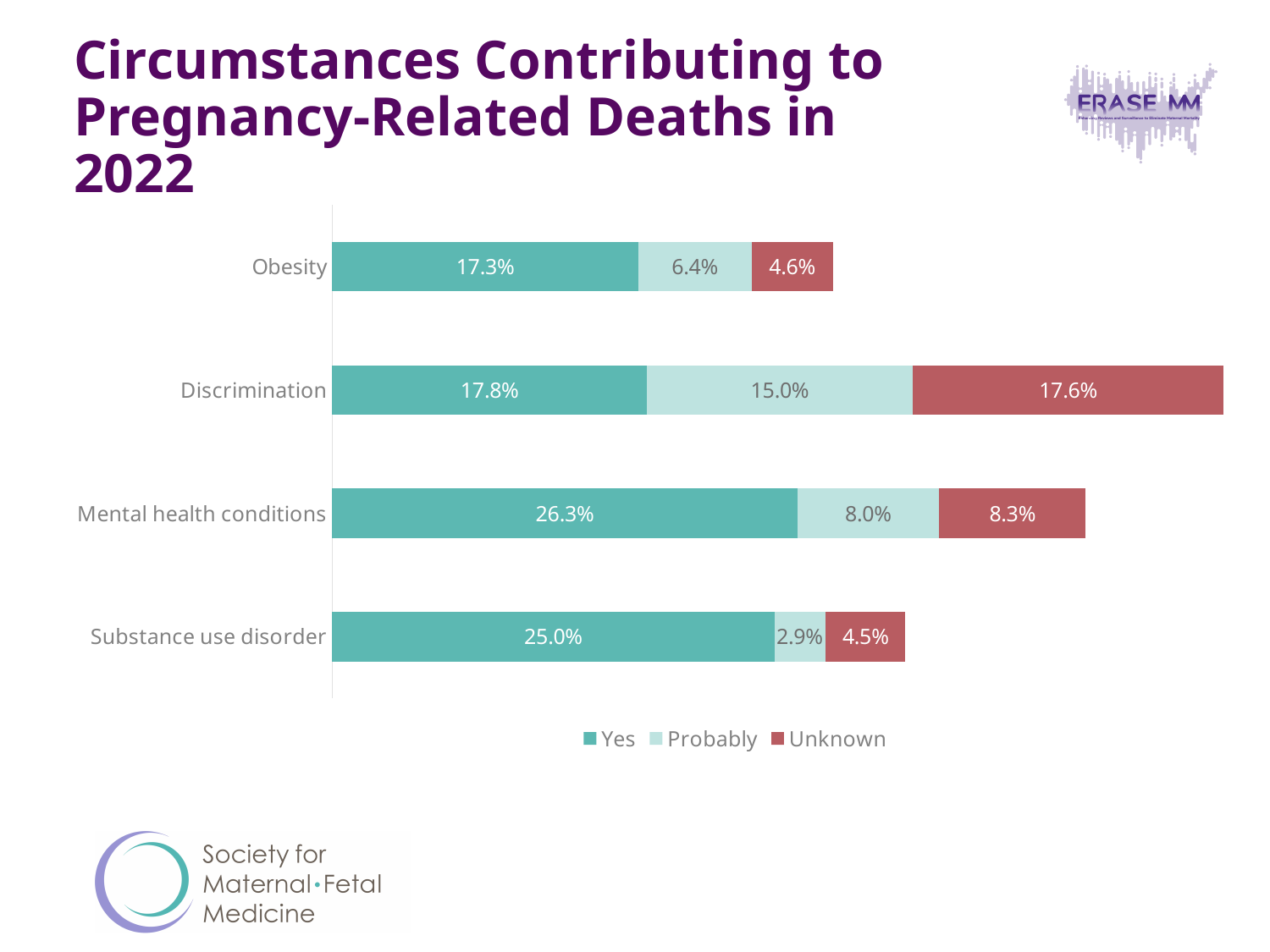
What is the total of the stacked bar for Obesity? 28.3% What is the 'Yes' value for Mental health conditions? 26.3% What is the 'Unknown' value for Substance use disorder? 4.5% How many series does the legend list? 3 Which series is shown in the darkest red colour in the legend? Unknown Which is larger, the 'Unknown' value for Discrimination or the 'Unknown' value for Mental health conditions? Discrimination Which category has the lowest 'Probably' value? Substance use disorder Which category has the highest 'Yes' value? Mental health conditions What is the 'Probably' value for Discrimination? 15.0% What kind of chart is shown on the slide? Stacked bar chart How many categories are shown on the chart? 4 What is the difference between the 'Yes' values for Mental health conditions and Substance use disorder? 1.3%